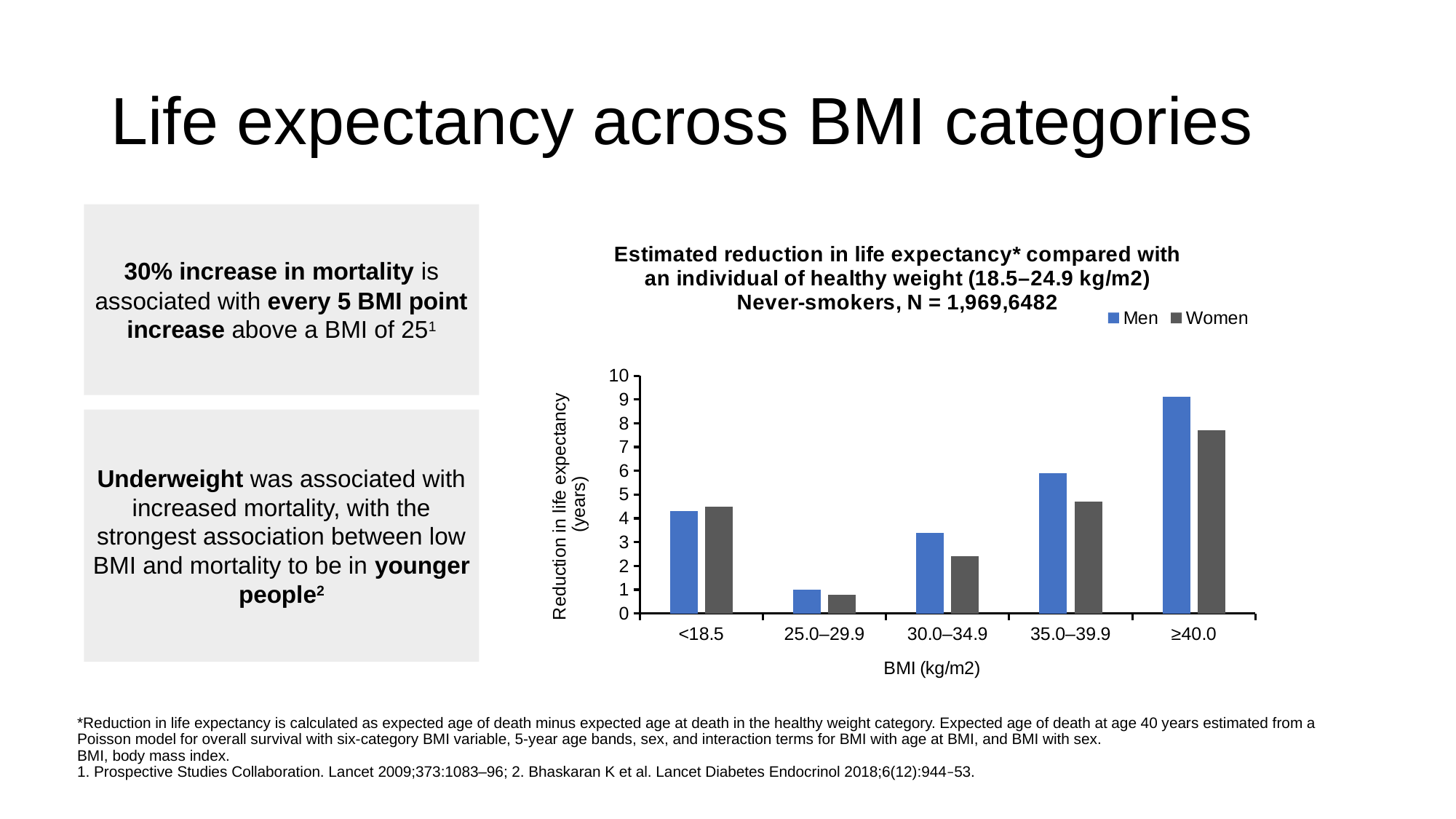
Which BMI category has the lowest reduction in life expectancy for Women? 25.0–29.9 What is the label of the y axis of the chart? Reduction in life expectancy (years) Is the reduction in life expectancy for Women in the 30.0–34.9 category greater or less than 3 years? less What kind of chart is shown on the slide? Bar chart Which BMI category has the highest reduction in life expectancy for Women? ≥40.0 In the ≥40.0 BMI category, which series has the larger reduction in life expectancy, Men or Women? Men Is the reduction in life expectancy for Men in the ≥40.0 category greater or less than 8 years? greater Which BMI category has the highest reduction in life expectancy for Men? ≥40.0 How many series does the chart legend list? 2 How many BMI categories are shown on the x axis of the chart? 5 In the 30.0–34.9 BMI category, which series has the larger reduction in life expectancy, Men or Women? Men Do the Men values rise or fall across the BMI categories from 25.0–29.9 to ≥40.0? Rise